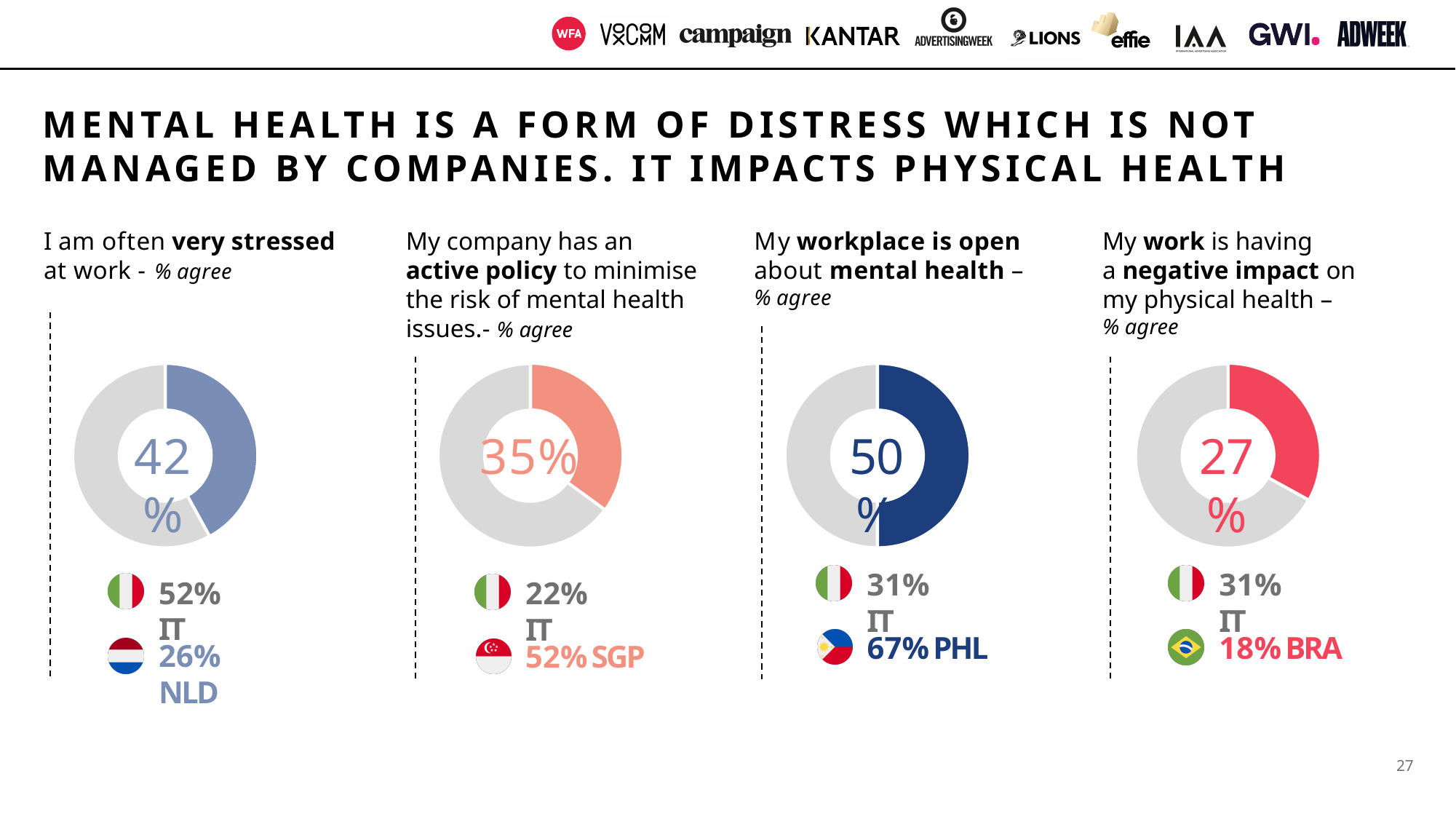
Which of the four statements has the highest overall % agree shown in its donut chart? My workplace is open about mental health In the donut chart for 'My workplace is open about mental health', what percentage is shown in the centre? 50% How many donut charts are shown on the slide? 4 What is the difference between the overall % agree for 'My workplace is open about mental health' and for 'My company has an active policy to minimise the risk of mental health issues'? 15% In the donut chart for 'My company has an active policy to minimise the risk of mental health issues', what percentage is shown in the centre? 35% Which is larger: the overall % agree for 'I am often very stressed at work' or for 'My work is having a negative impact on my physical health'? I am often very stressed at work In the donut chart for 'My work is having a negative impact on my physical health', what percentage is shown in the centre? 27% In the donut chart for 'I am often very stressed at work', what share of the ring is coloured blue (the agree portion)? 42% What kind of chart is used to show each of the four '% agree' figures on the slide? Donut (pie) chart In the donut chart for 'I am often very stressed at work', what percentage is shown in the centre? 42% Below the donut chart for 'My workplace is open about mental health', what % agree is shown for PHL? 67% Which of the four statements has the lowest overall % agree shown in its donut chart? My work is having a negative impact on my physical health